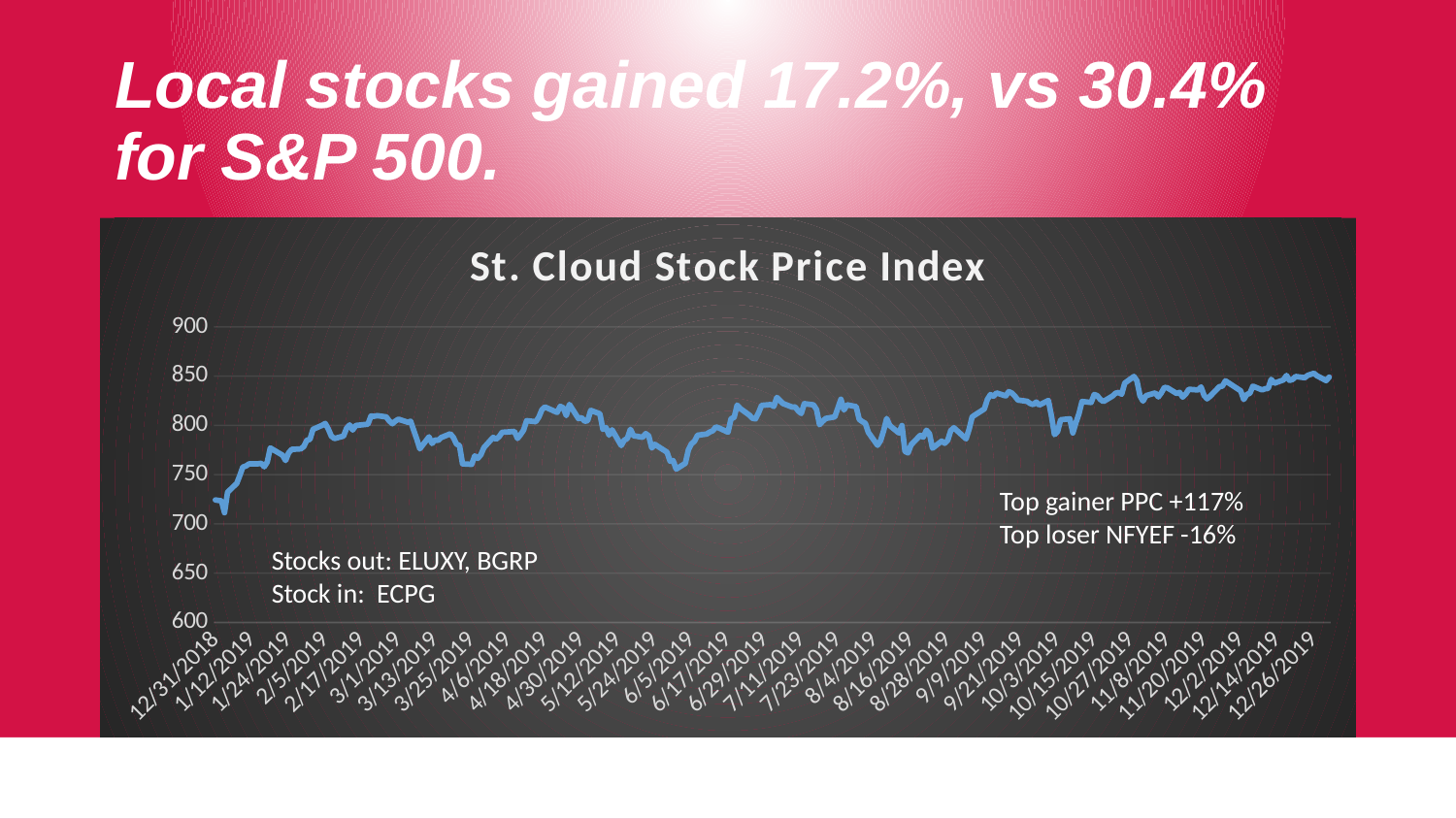
At which date label is the index at its lowest value? 12/31/2018 Is the value of the index at 8/28/2019 greater or less than 800? less Which is higher, the index value at 12/31/2018 or at 12/26/2019? 12/26/2019 What is the title of the chart? St. Cloud Stock Price Index How many date labels are shown on the x axis? 31 Is the value of the index at 12/31/2018 greater or less than 750? less Is the value of the index at 12/26/2019 greater or less than 800? greater Overall, does the St. Cloud Stock Price Index rise or fall from 12/31/2018 to 12/26/2019? rise What colour is the line in the chart? blue What kind of chart is shown on the slide? line chart Which is higher, the index value at 6/5/2019 or at 10/27/2019? 10/27/2019